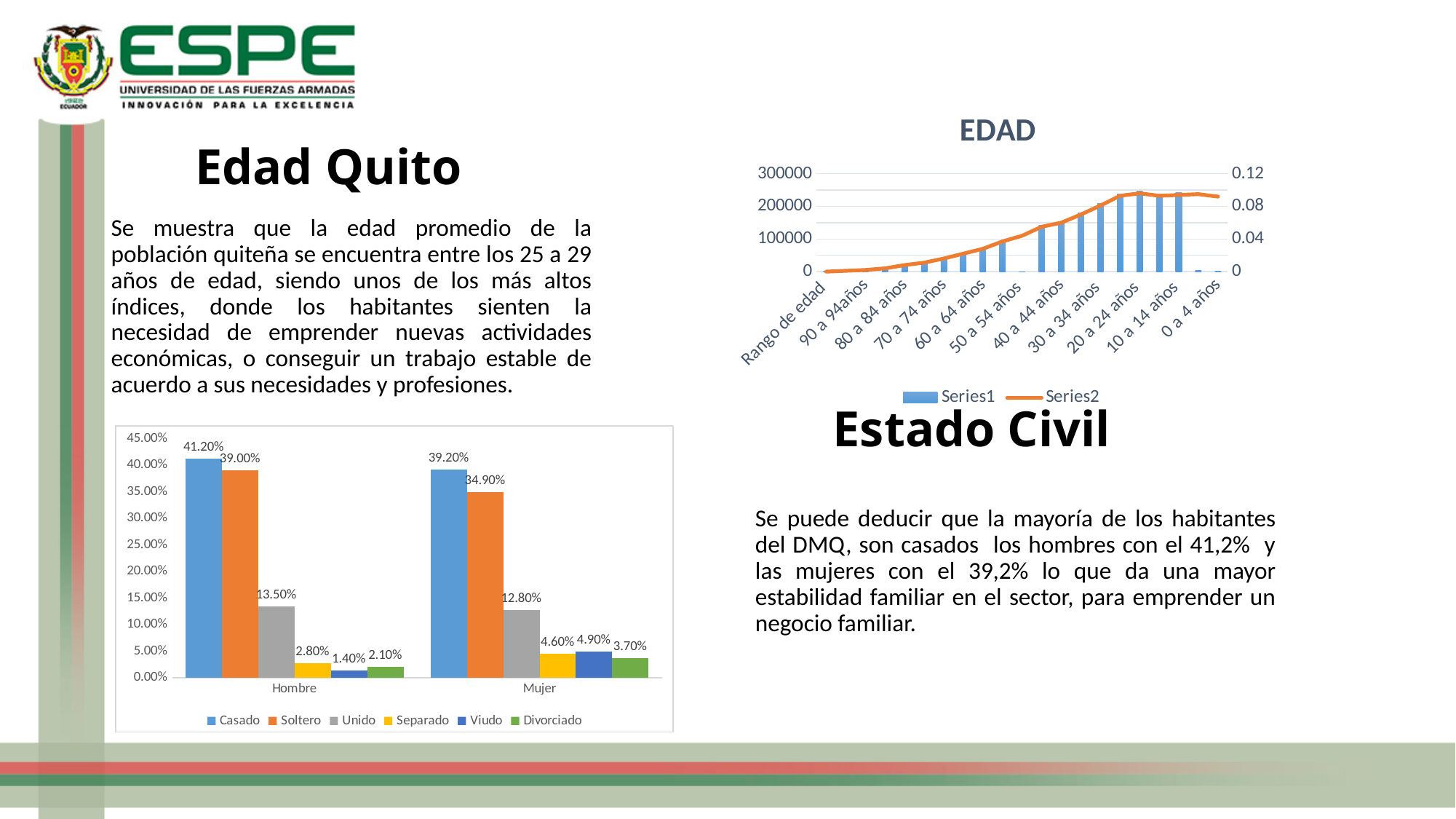
In the Estado Civil chart (bottom left), which category has the highest value in the Hombre group? Casado What kind of chart is the Estado Civil chart (bottom left)? Bar chart In the EDAD chart (top right), is the Series1 bar for 0 a 4 años greater or less than 100000? less In the EDAD chart (top right), is the Series1 bar for 20 a 24 años greater or less than 200000? greater In the Estado Civil chart (bottom left), what is the value for Viudo in the Hombre group? 1.40% In the Estado Civil chart (bottom left), how many series does the legend list? 6 In the Estado Civil chart (bottom left), what is the value for Soltero in the Mujer group? 34.90% In the Estado Civil chart (bottom left), what is the difference between Casado and Soltero in the Hombre group? 2.20% In the Estado Civil chart (bottom left), what is the value for Casado in the Hombre group? 41.20% In the Estado Civil chart (bottom left), which category has the lowest value in the Mujer group? Divorciado In the Estado Civil chart (bottom left), which is larger: Unido for Hombre or Unido for Mujer? Unido for Hombre In the EDAD chart (top right), how many series does the legend list? 2